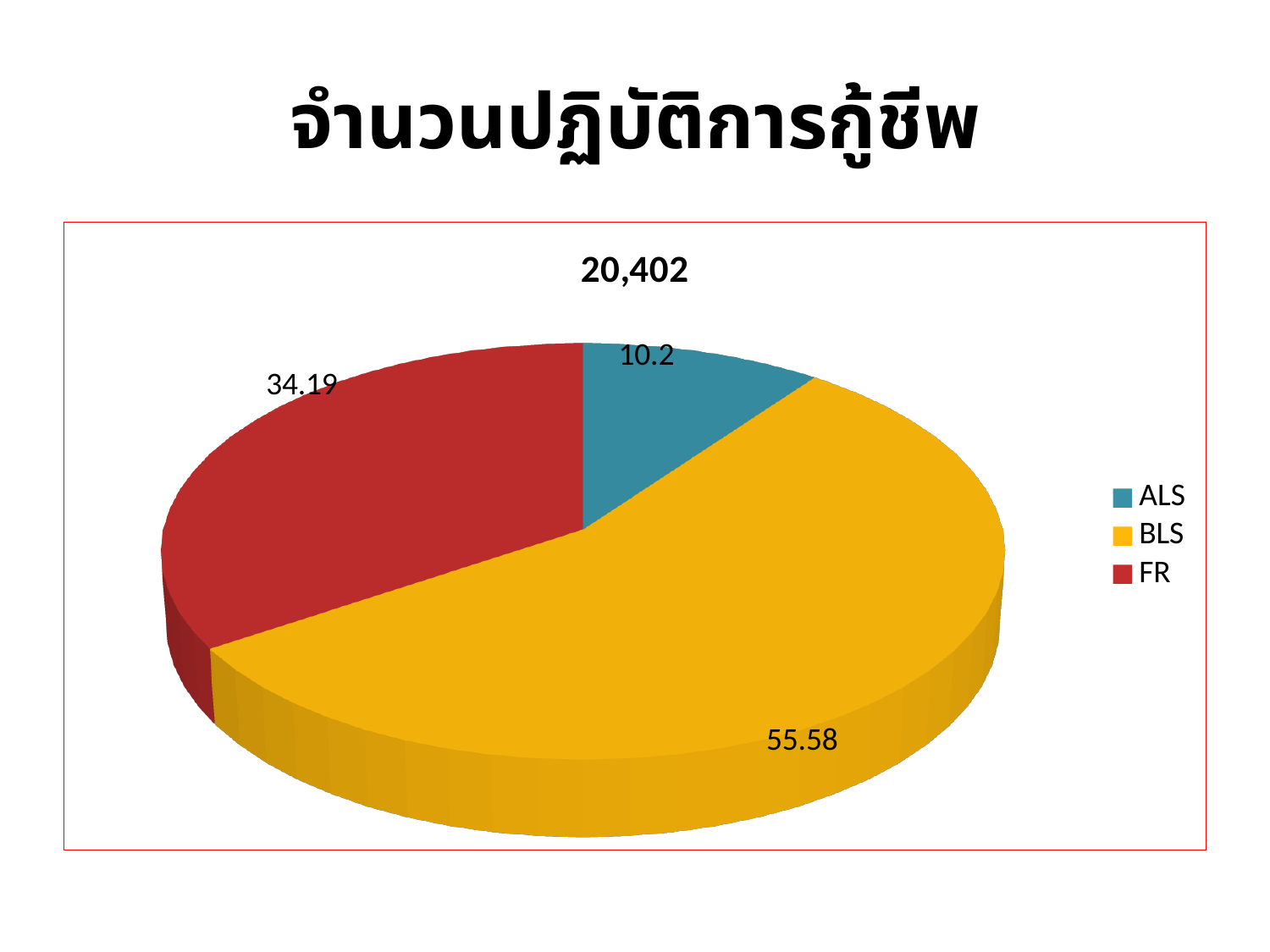
How many slices does the pie chart have? 3 Which category has the smallest slice of the pie? ALS What is the difference between the FR value and the ALS value? 23.99 What is the value shown for the FR slice? 34.19 What is the difference between the BLS value and the FR value? 21.39 What is the value shown for the BLS slice? 55.58 Which is larger, the FR slice or the ALS slice? FR What is the value shown for the ALS slice? 10.2 What kind of chart is shown on the slide? Pie chart What number is shown as the title above the pie chart? 20,402 How many entries does the legend list? 3 Which category has the largest slice of the pie? BLS